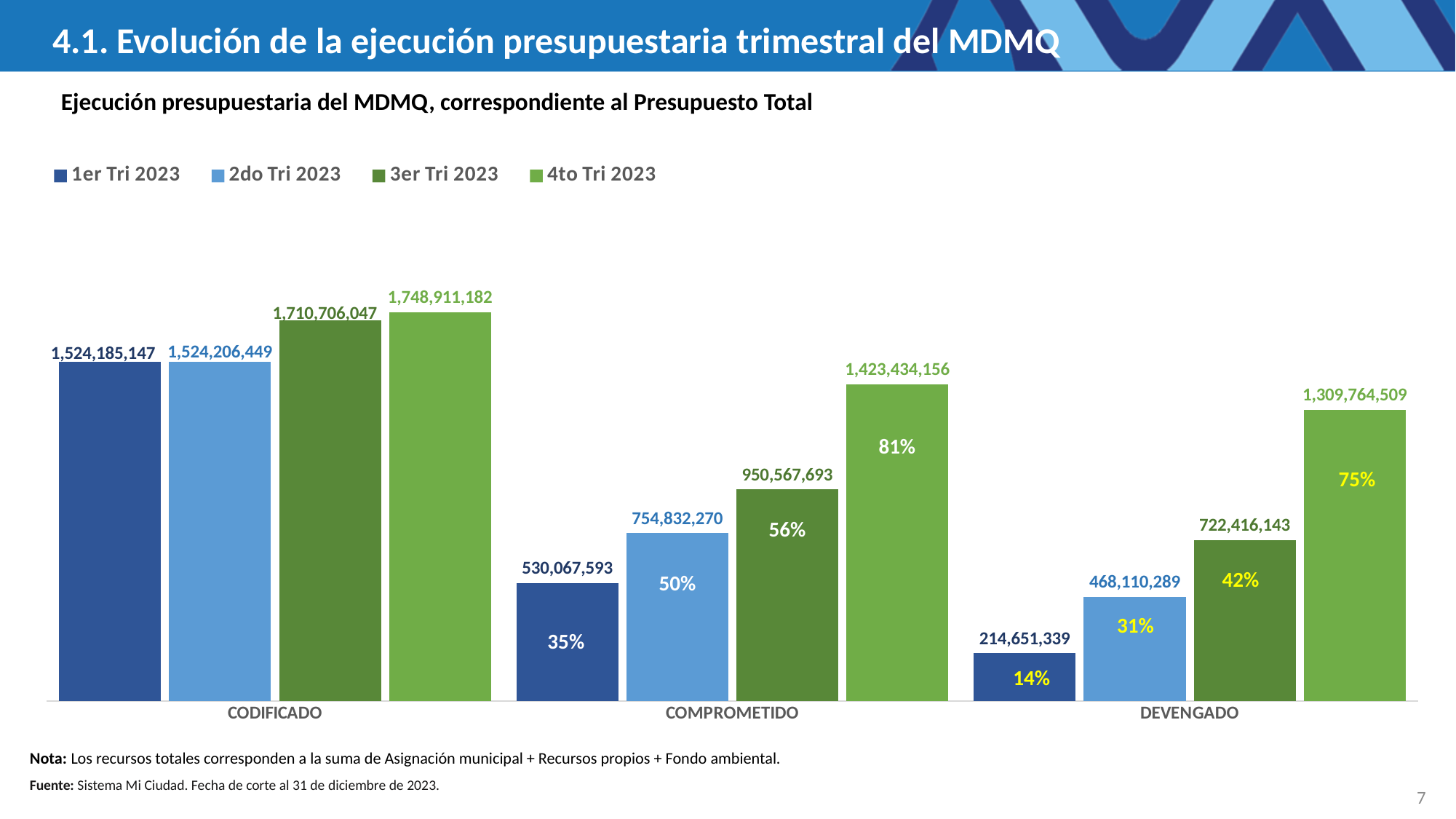
What is the value of the 4to Tri 2023 bar for CODIFICADO? 1,748,911,182 What is the value of the 3er Tri 2023 bar for COMPROMETIDO? 950,567,693 Which bar has the highest value in the chart? 4to Tri 2023 for CODIFICADO (1,748,911,182) What is the value of the 1er Tri 2023 bar for DEVENGADO? 214,651,339 Do the COMPROMETIDO values rise or fall from 1er Tri 2023 to 4to Tri 2023? Rise How many series does the legend list? 4 What kind of chart is shown on the slide? Bar chart What is the difference between the 4to Tri 2023 and 3er Tri 2023 values for COMPROMETIDO? 472,866,463 Which is larger: the 3er Tri 2023 value for COMPROMETIDO or the 4to Tri 2023 value for DEVENGADO? 4to Tri 2023 value for DEVENGADO Which bar has the lowest value in the chart? 1er Tri 2023 for DEVENGADO (214,651,339) How many categories are shown on the x axis of the chart? 3 What is the difference between the 2do Tri 2023 and 1er Tri 2023 values for DEVENGADO? 253,458,950